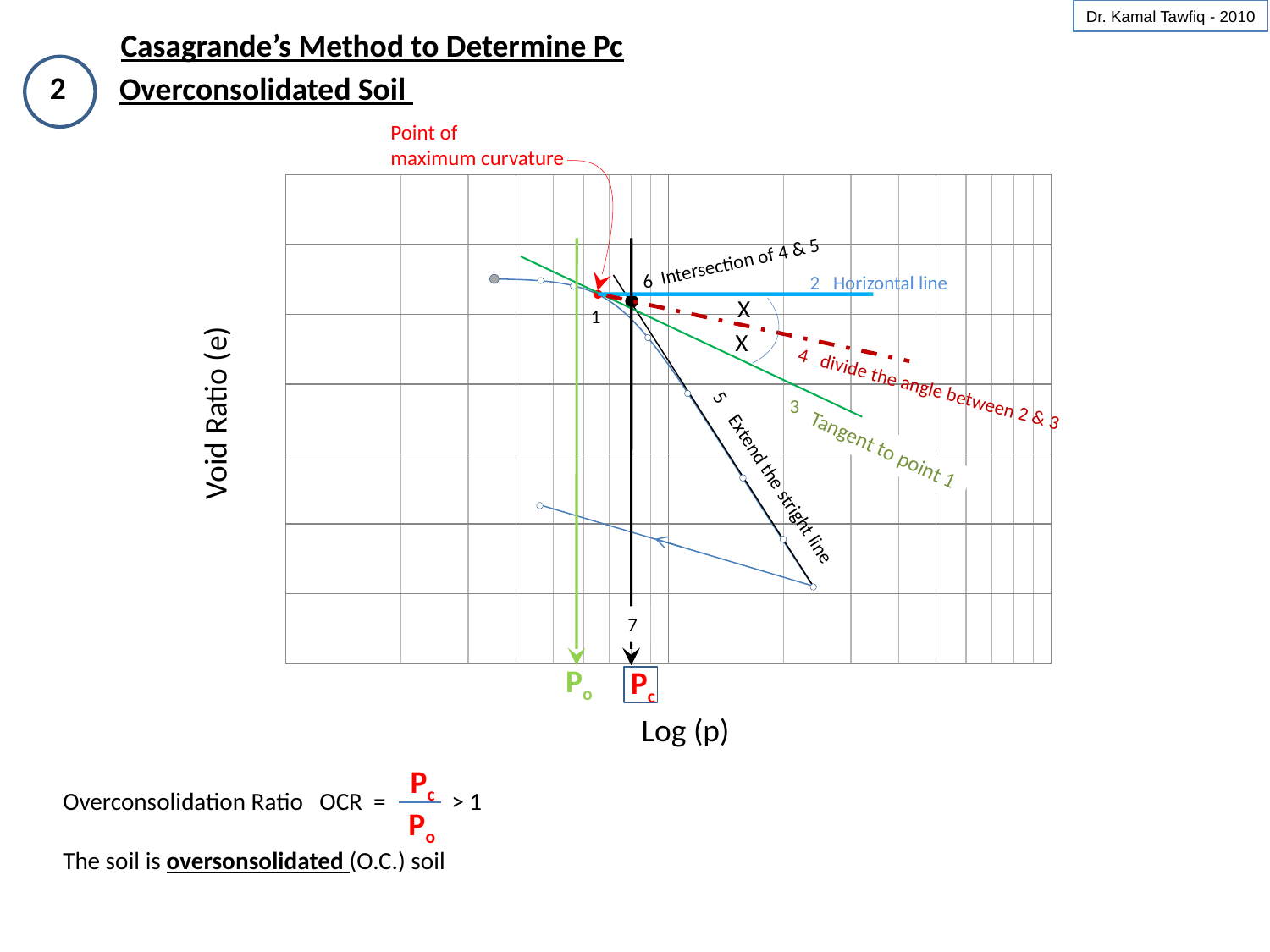
What is the label of the horizontal axis of the chart? Log (p) Which pressure is located further to the right on the Log (p) axis, Po or Pc? Pc What is the label of the vertical axis of the chart? Void Ratio (e) Along the main curve, does the void ratio rise or fall as Log (p) increases? fall What kind of chart is shown on the slide? line chart According to the chart, is Pc larger or smaller than Po? larger